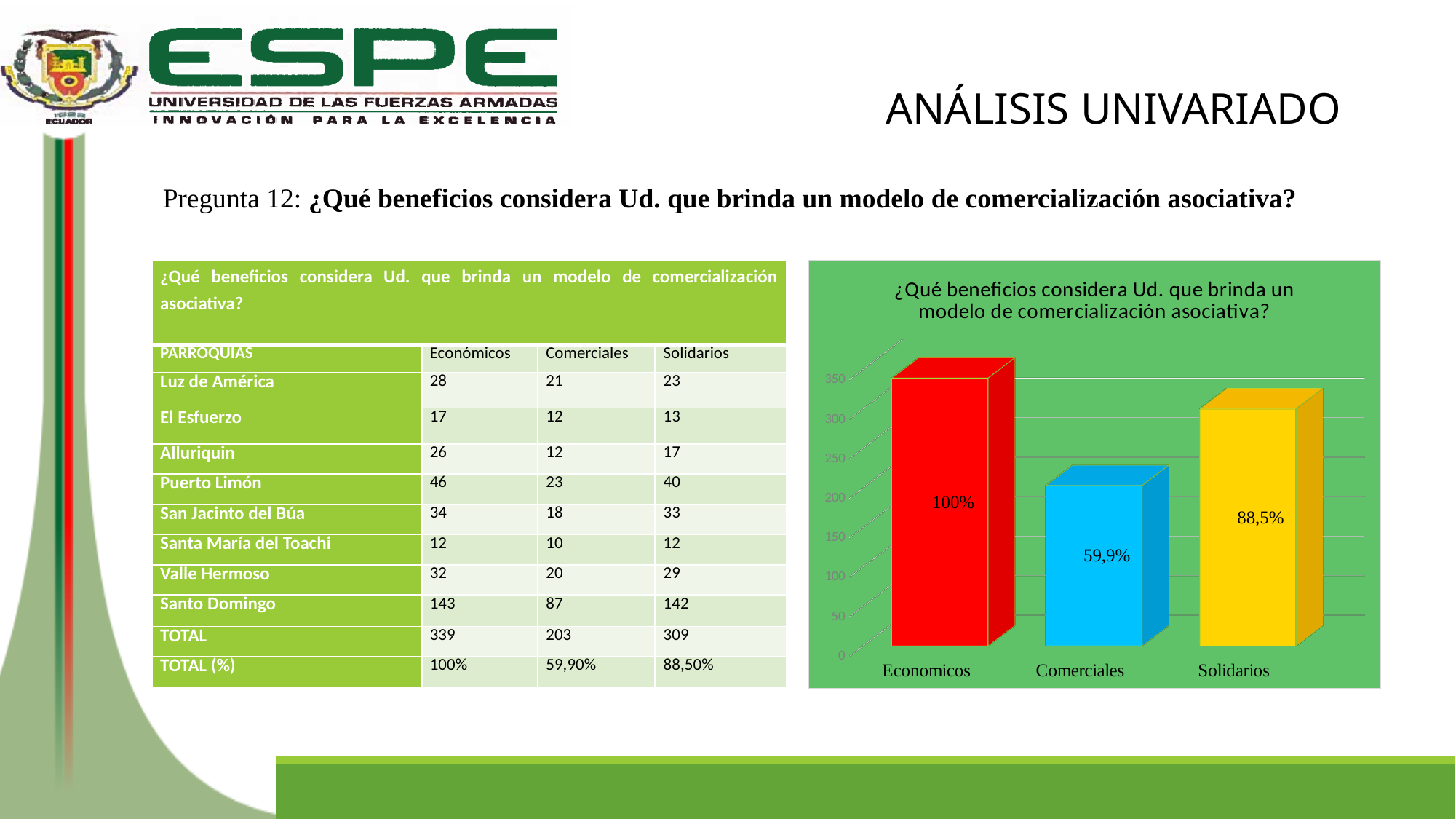
What is the data label shown on the Economicos bar? 100% Is the value for the Comerciales bar greater or less than 250 on the axis? less What colour is the Economicos bar in the chart? red Is the value for the Economicos bar greater or less than 300 on the axis? greater What is the difference between the percentage labels of Economicos and Comerciales? 40,1% Which bar is taller, Solidarios or Comerciales? Solidarios How many categories are plotted in the chart? 3 Which category has the shortest bar in the chart? Comerciales Which category has the tallest bar in the chart? Economicos What is the data label shown on the Comerciales bar? 59,9% What is the data label shown on the Solidarios bar? 88,5% What kind of chart is shown on the slide? bar chart